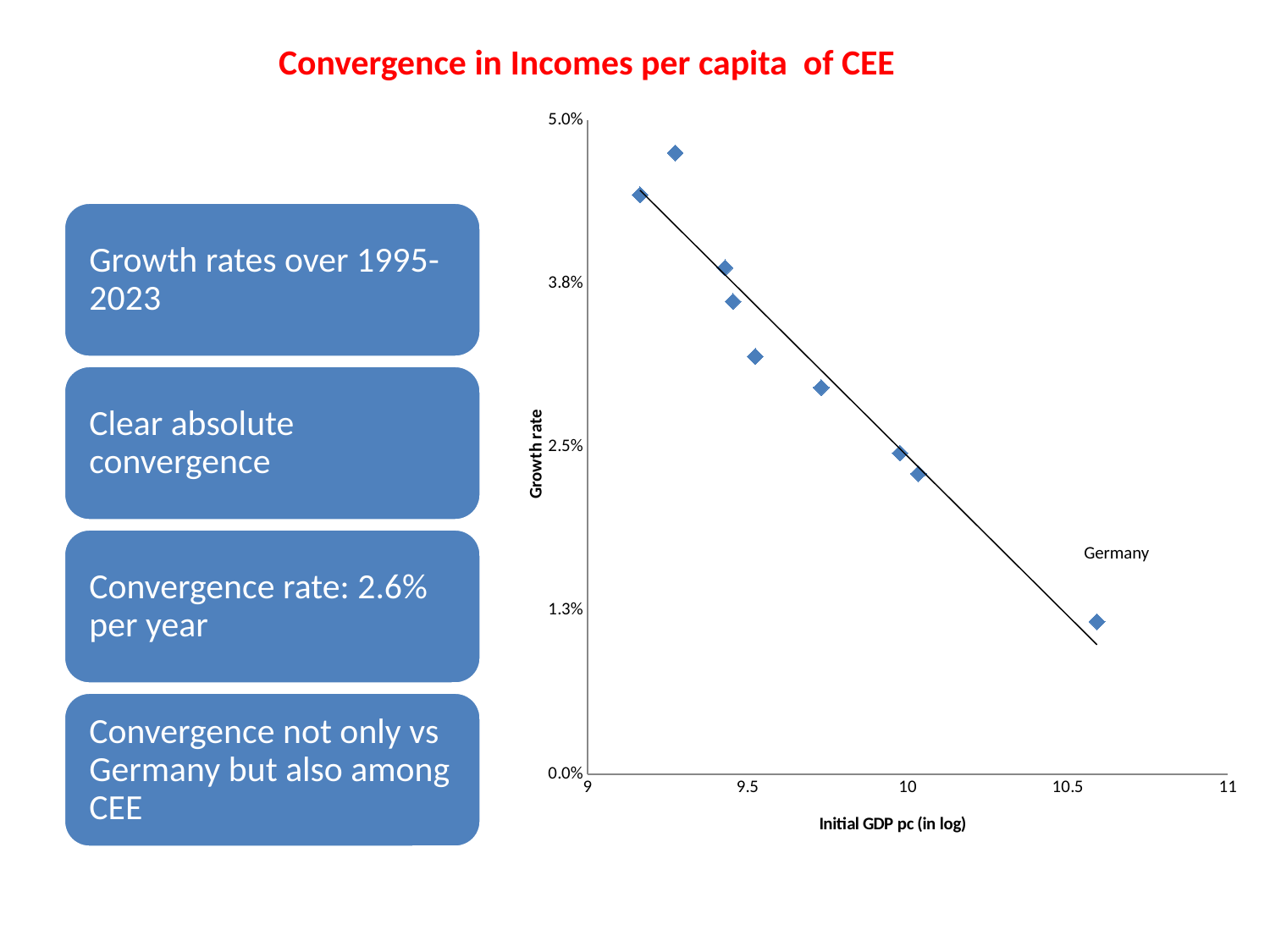
What is the highest value shown on the y axis? 5.0% What kind of chart is shown on the slide? scatter chart Is the initial GDP pc (in log) for Germany greater or less than 10.5? greater What is the label of the x axis? Initial GDP pc (in log) Is the growth rate for Germany greater or less than 2.5%? less Is the lowest plotted growth rate greater or less than 2.5%? less How many data points are plotted in the chart? 9 As initial GDP per capita increases along the x axis, does the growth rate rise or fall? fall Which point has the lowest growth rate, the one labelled Germany or the leftmost point? Germany Which country is labelled on the chart? Germany